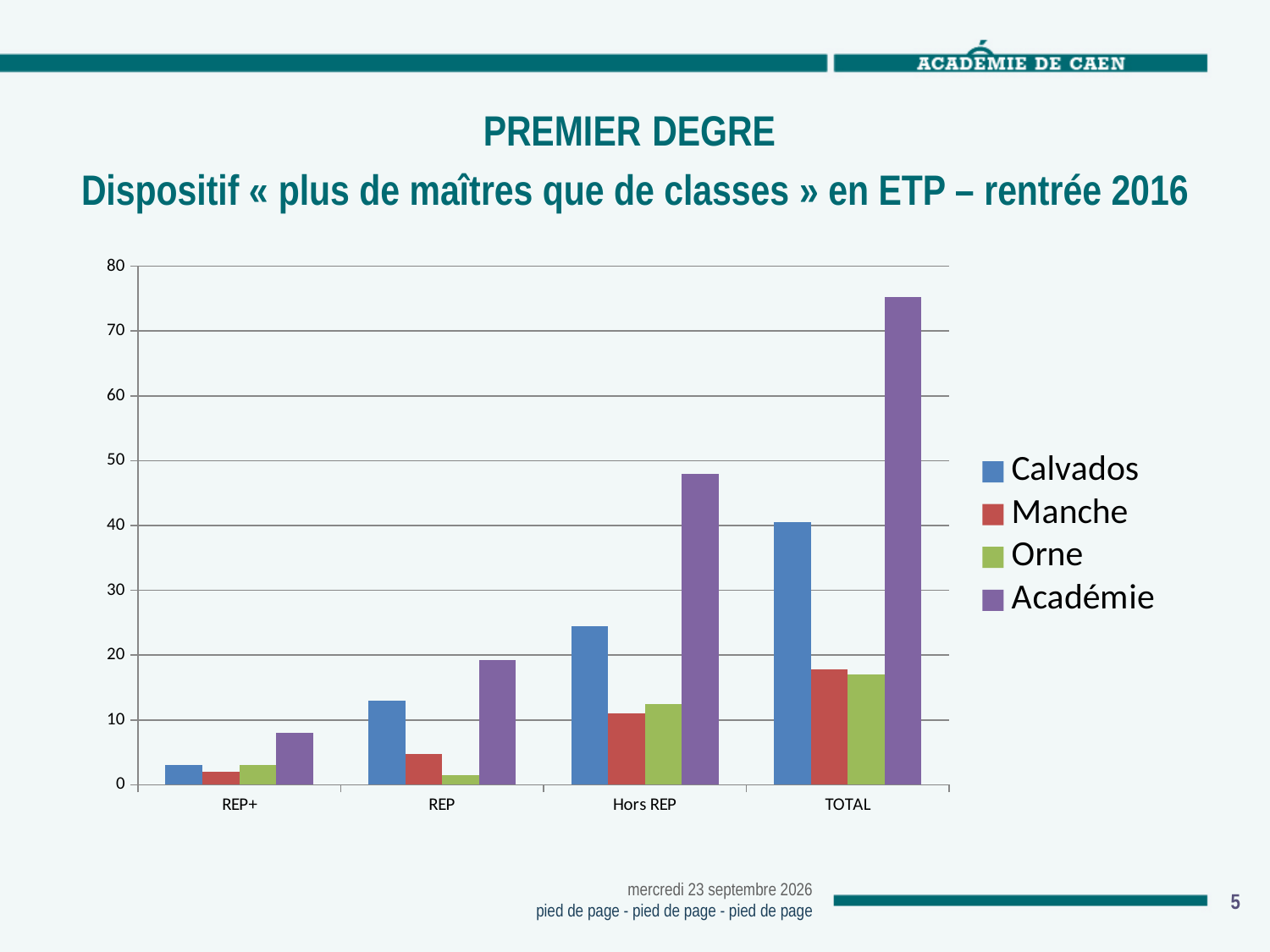
In the Hors REP category, which is larger: Calvados or Manche? Calvados Is the Calvados value for TOTAL greater or less than 50? less In which category is the Académie bar the highest? TOTAL Which colour represents Académie in the legend? purple Is the Académie value for TOTAL greater or less than 70? greater Is the Calvados value for REP greater or less than 10? greater What kind of chart is shown on the slide? bar chart In the REP category, which is larger: Manche or Orne? Manche How many series does the legend list? 4 Do the Académie bars rise or fall from REP+ to TOTAL along the x axis? rise How many categories are shown on the x axis? 4